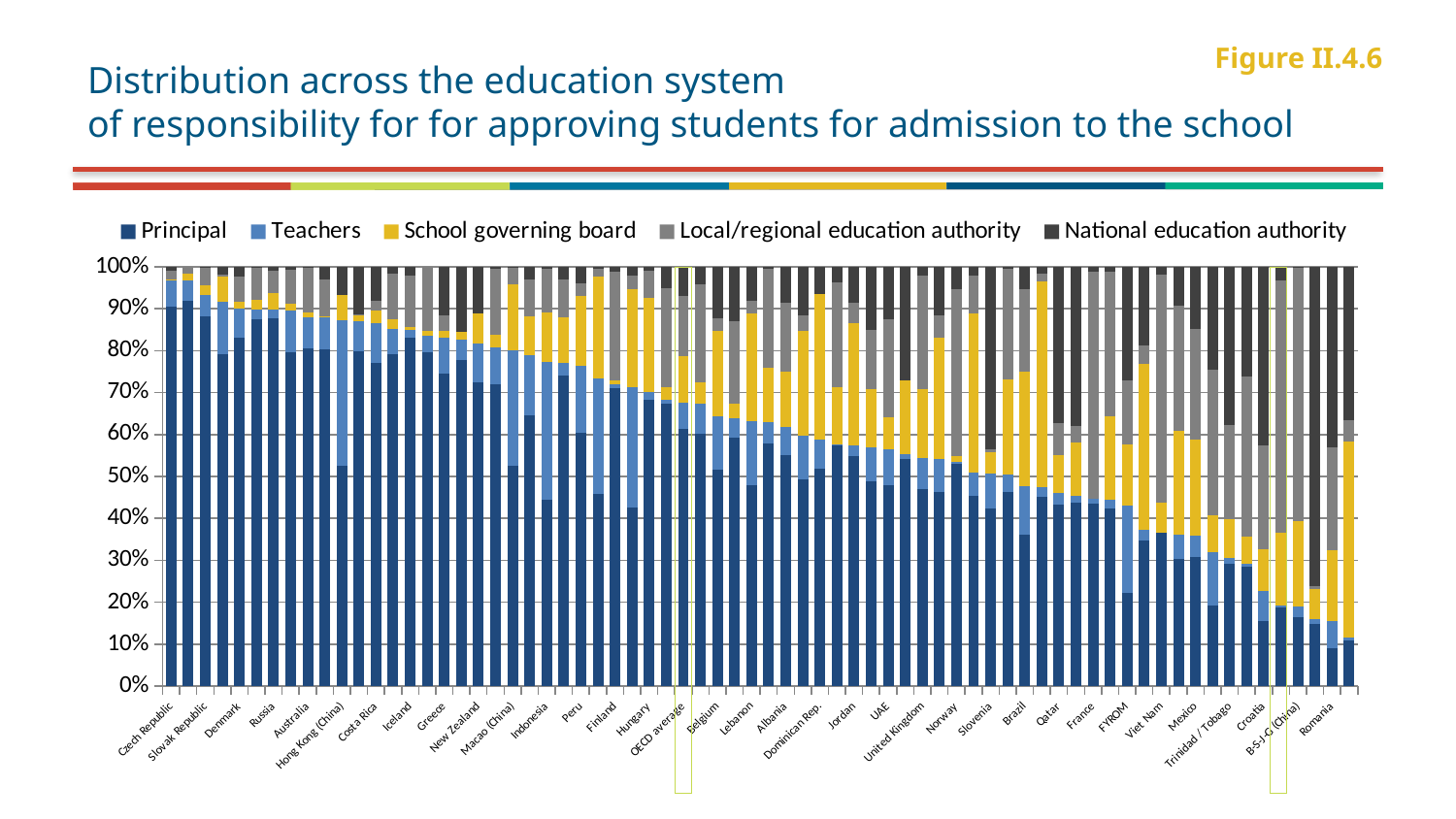
What are the five series listed in the legend? Principal, Teachers, School governing board, Local/regional education authority, National education authority Which country has the lowest Principal share? Romania Which has the larger Principal share, the Czech Republic or Romania? Czech Republic Is the Principal share for the Czech Republic greater or less than 80%? greater How many series does the legend list? 5 What kind of chart is shown on the slide? Stacked bar chart Does the Principal share rise or fall moving from left to right along the x axis? fall Is the Principal share for the OECD average greater or less than 50%? greater Is the Principal share for Romania greater or less than 20%? less Which series accounts for the largest share of the bar for the Czech Republic? Principal What is the figure number shown on the slide? Figure II.4.6 What is the maximum value shown on the vertical axis? 100%